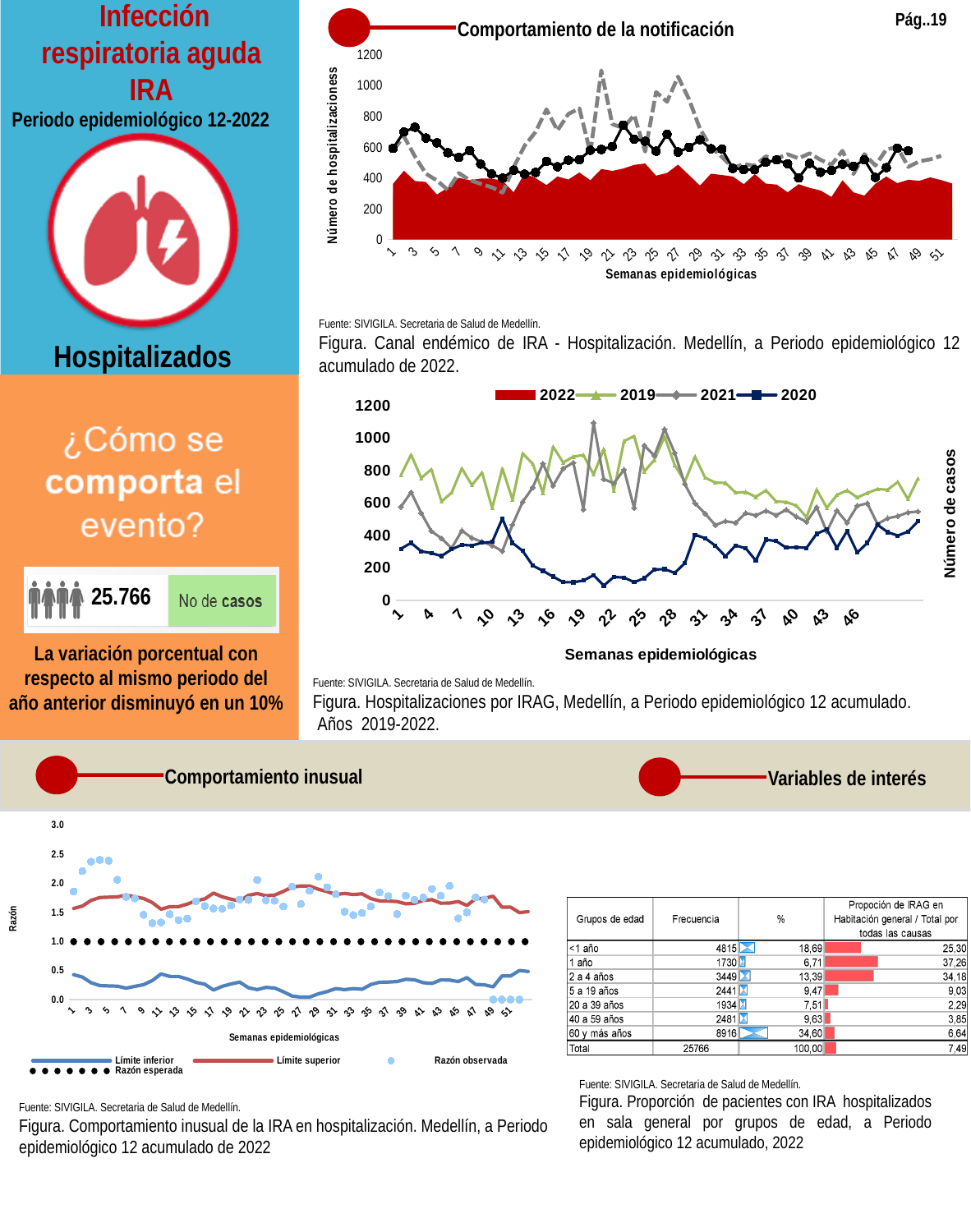
What is the highest tick value shown on the vertical axis of the 'Comportamiento de la notificación' chart? 1200 In the 'Comportamiento inusual' chart at the bottom left, at what constant value does the 'Razón esperada' line sit? 1.0 In the 'Hospitalizaciones por IRAG' chart, which series has the higher value at week 1, 2019 or 2020? 2019 What kind of chart is the 'Hospitalizaciones por IRAG' chart in the middle right of the slide? line chart How many series does the legend of the 'Comportamiento inusual' chart list? 4 In the 'Comportamiento inusual' chart, is the 'Límite inferior' value at week 1 greater or less than 1.0? less In the 'Hospitalizaciones por IRAG' chart, is the value for 2019 at week 1 greater or less than 600? greater What is the label of the vertical axis of the 'Comportamiento de la notificación' chart at the top right? Número de hospitalizacioness How many series does the legend of the 'Hospitalizaciones por IRAG' chart list? 4 Which years are listed in the legend of the 'Hospitalizaciones por IRAG' chart? 2022, 2019, 2021, 2020 In the 'Hospitalizaciones por IRAG' chart, which series has the highest value at week 1? 2019 In the 'Hospitalizaciones por IRAG' chart, is the value for 2020 at week 1 greater or less than 400? less